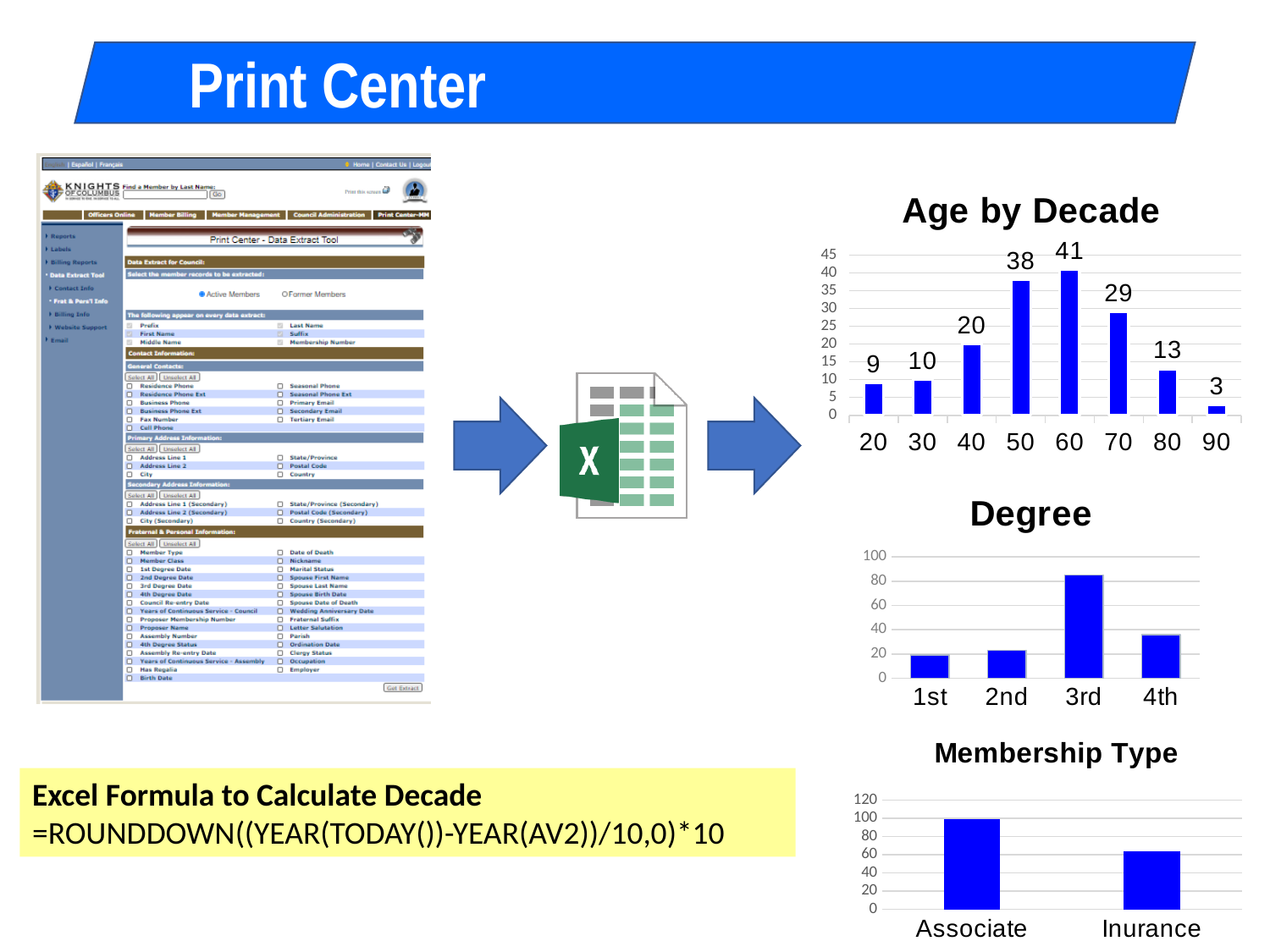
In the Age by Decade chart, what is the difference between the values for 60 and 70? 12 What kind of chart is the Degree chart? bar chart In the Age by Decade chart, which category has the highest value? 60 In the Degree chart, which category has the highest value? 3rd In the Age by Decade chart, what is the value for the 50 category? 38 In the Membership Type chart, which of the two categories has the larger value? Associate In the Age by Decade chart, how many categories are shown on the x axis? 8 In the Age by Decade chart, what is the value for the 80 category? 13 In the Membership Type chart, is the value for Inurance greater or less than 80? less In the Age by Decade chart, which category has the lowest value? 90 In the Degree chart, is the value for 3rd greater or less than 80? greater